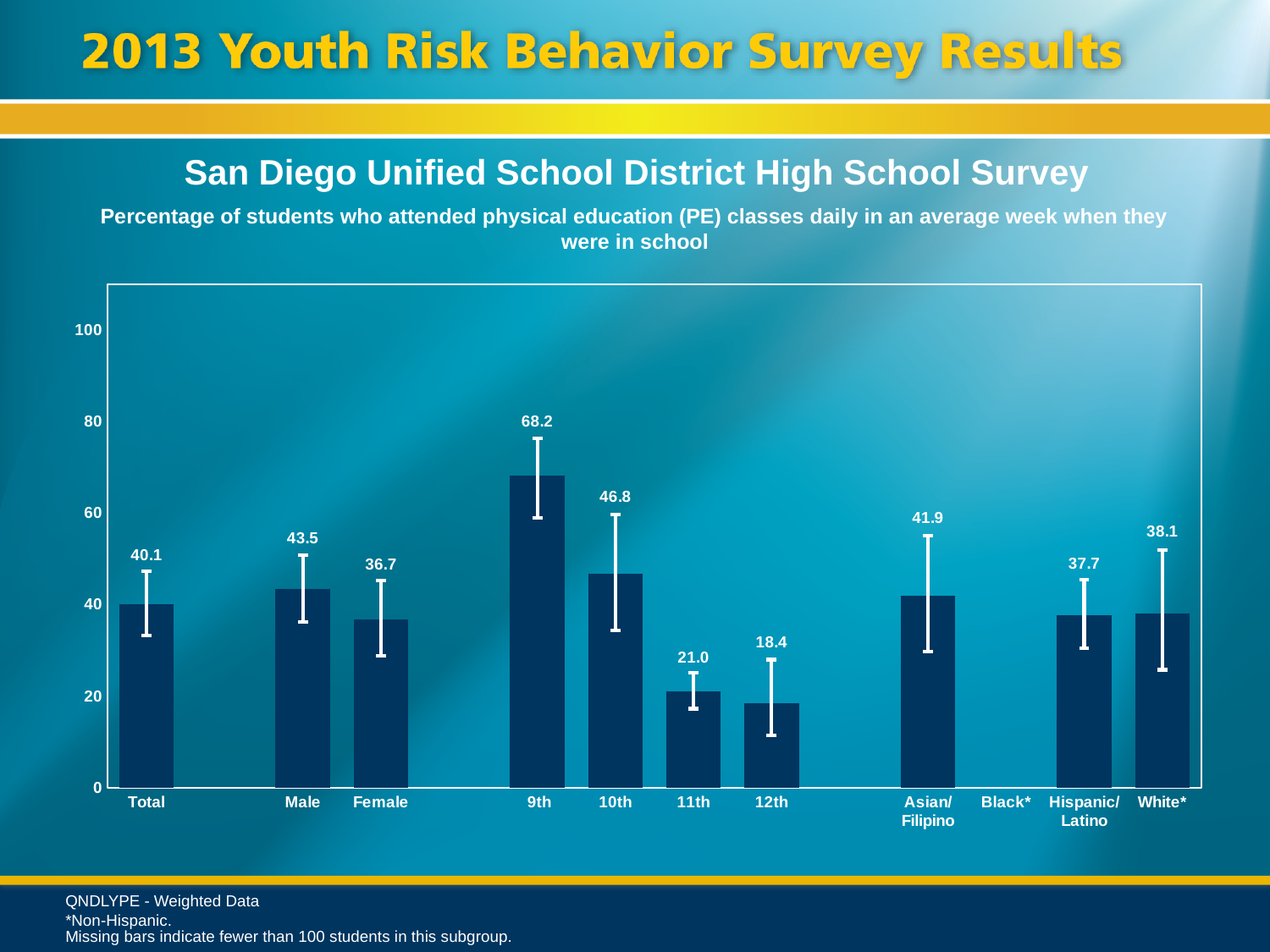
Which is larger, the value for 10th grade or the value for 11th grade? 10th How many bars are plotted on the chart? 10 What percentage of students in the Total category attended PE classes daily? 40.1 Is the value for 9th grade greater or less than 60? greater What kind of chart is shown on the slide? Bar chart Which category has the lowest percentage of students attending PE classes daily? 12th What is the value shown for Asian/Filipino students? 41.9 Do the values rise or fall from 9th grade to 12th grade? Fall Which category has the highest percentage of students attending PE classes daily? 9th What is the difference between the Male and Female values? 6.8 What is the value shown for 9th grade students? 68.2 What is the difference between the 9th grade and 12th grade values? 49.8